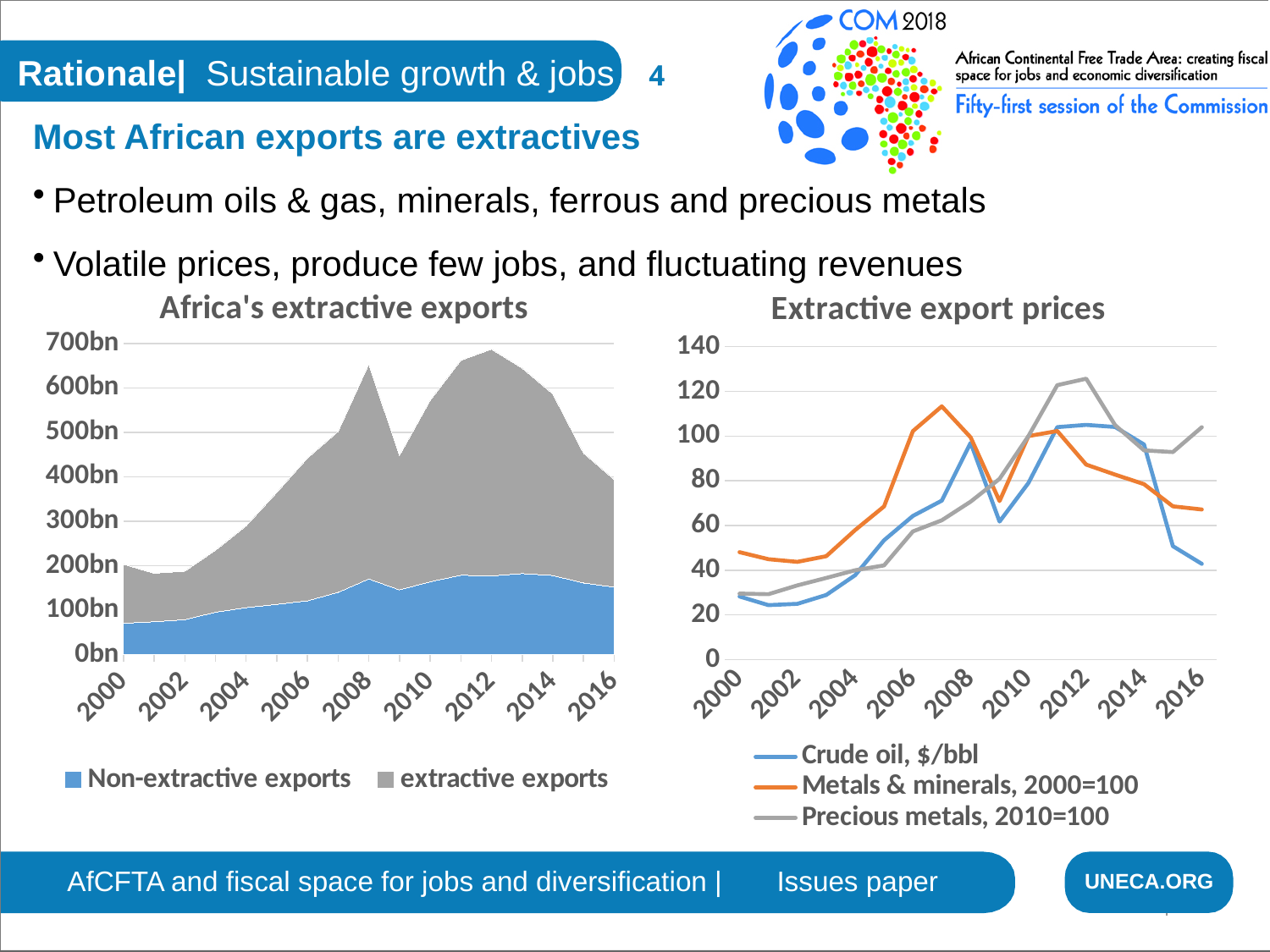
In the 'Africa's extractive exports' chart, is the value for Non-extractive exports in 2000 greater or less than 100bn? less In the 'Africa's extractive exports' chart, is the total of exports in 2008 greater or less than 600bn? greater How many series does the legend of the 'Africa's extractive exports' chart list? 2 What kind of chart is the 'Africa's extractive exports' chart? Stacked area chart In the 'Extractive export prices' chart, does the Crude oil series rise or fall between 2013 and 2016? Fall In the 'Extractive export prices' chart, is the value for Precious metals in 2000 greater or less than 40? less What kind of chart is the 'Extractive export prices' chart? Line chart In the 'Africa's extractive exports' chart, which colour represents extractive exports? Grey How many series does the legend of the 'Extractive export prices' chart list? 3